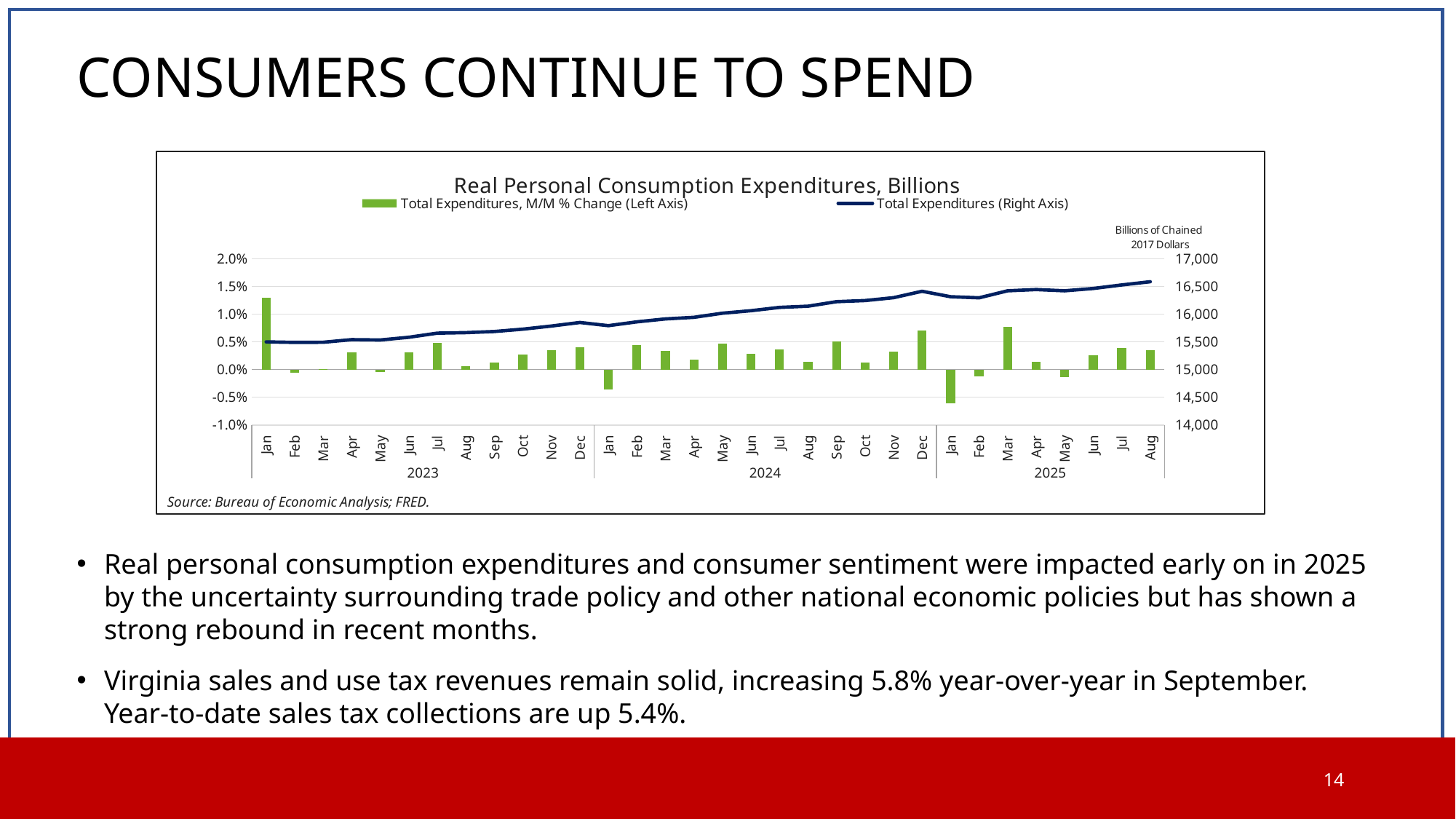
Which has the larger M/M % Change bar, Dec 2024 or Feb 2025? Dec 2024 How many series does the chart's legend list? 2 What is the title of the chart? Real Personal Consumption Expenditures, Billions Does the Total Expenditures line generally rise or fall from Jan 2023 to Aug 2025? rise What kind of chart is shown on the slide? A combination bar and line chart Is the M/M % Change bar for Mar 2025 greater or less than 0.5%? greater Is the Total Expenditures line value for Jan 2023 greater or less than 16,000? less Is the Total Expenditures line value for Aug 2025 greater or less than 16,000? greater Which month has the lowest Total Expenditures, M/M % Change bar? Jan 2025 How many months are plotted along the x axis of the chart? 32 Which month has the highest Total Expenditures, M/M % Change bar? Jan 2023